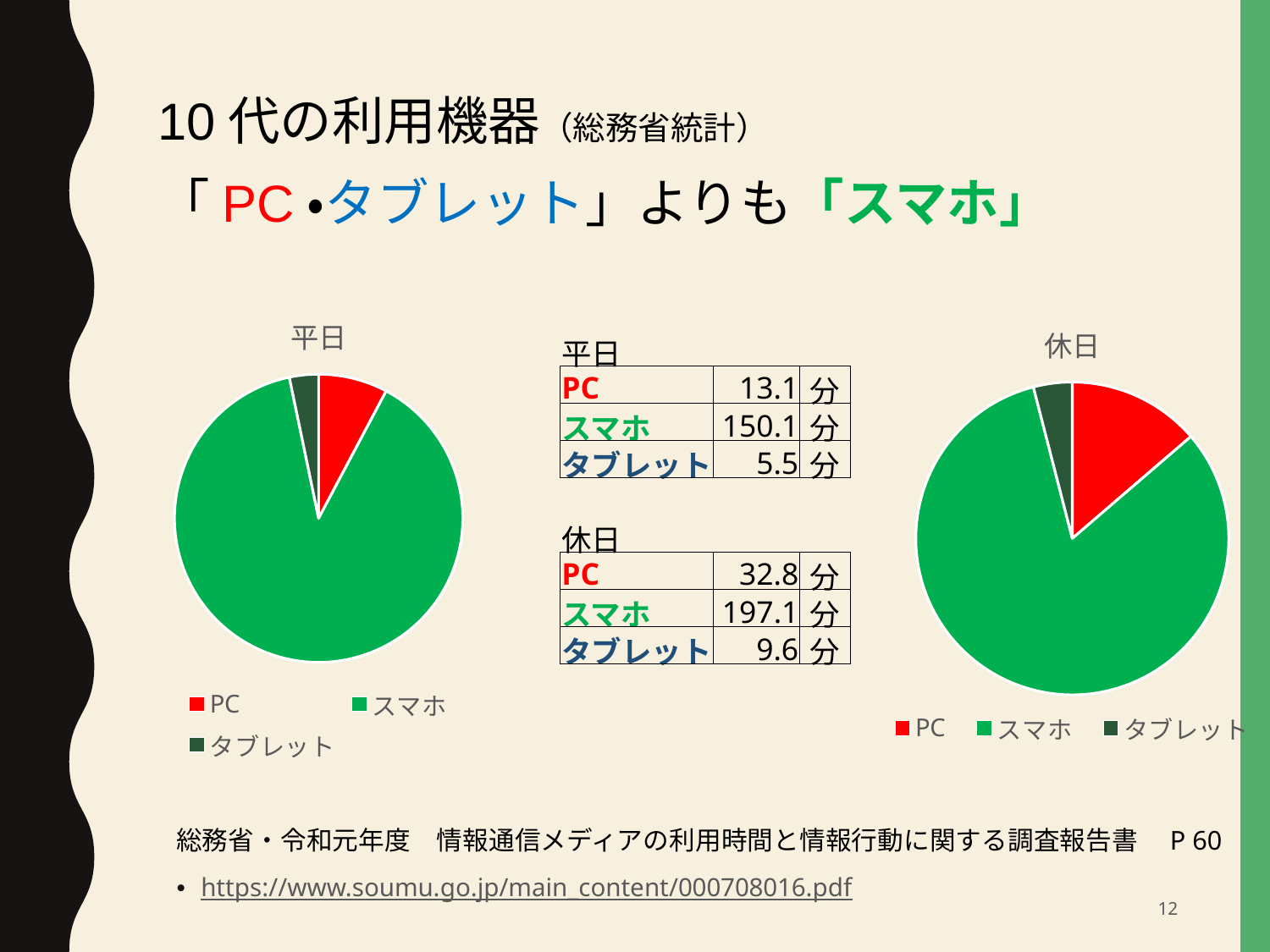
In the 平日 chart, what is the value for スマホ? 150.1 分 In the 平日 chart, what is the difference between the values for PC and タブレット? 7.6 分 In the 平日 chart, what colour is the スマホ slice? green How many categories does the 休日 pie chart have? 3 What type of chart is the 平日 chart on the left of the slide? pie chart In the 休日 chart, which category has the largest slice? スマホ In the 平日 chart, what is the value for PC? 13.1 分 In the 平日 chart, which category has the smallest slice? タブレット In the 休日 chart, what is the difference between the values for スマホ and PC? 164.3 分 In the 休日 chart, which is larger, PC or タブレット? PC In the 休日 chart, what is the value for スマホ? 197.1 分 In the 休日 chart, what is the value for タブレット? 9.6 分